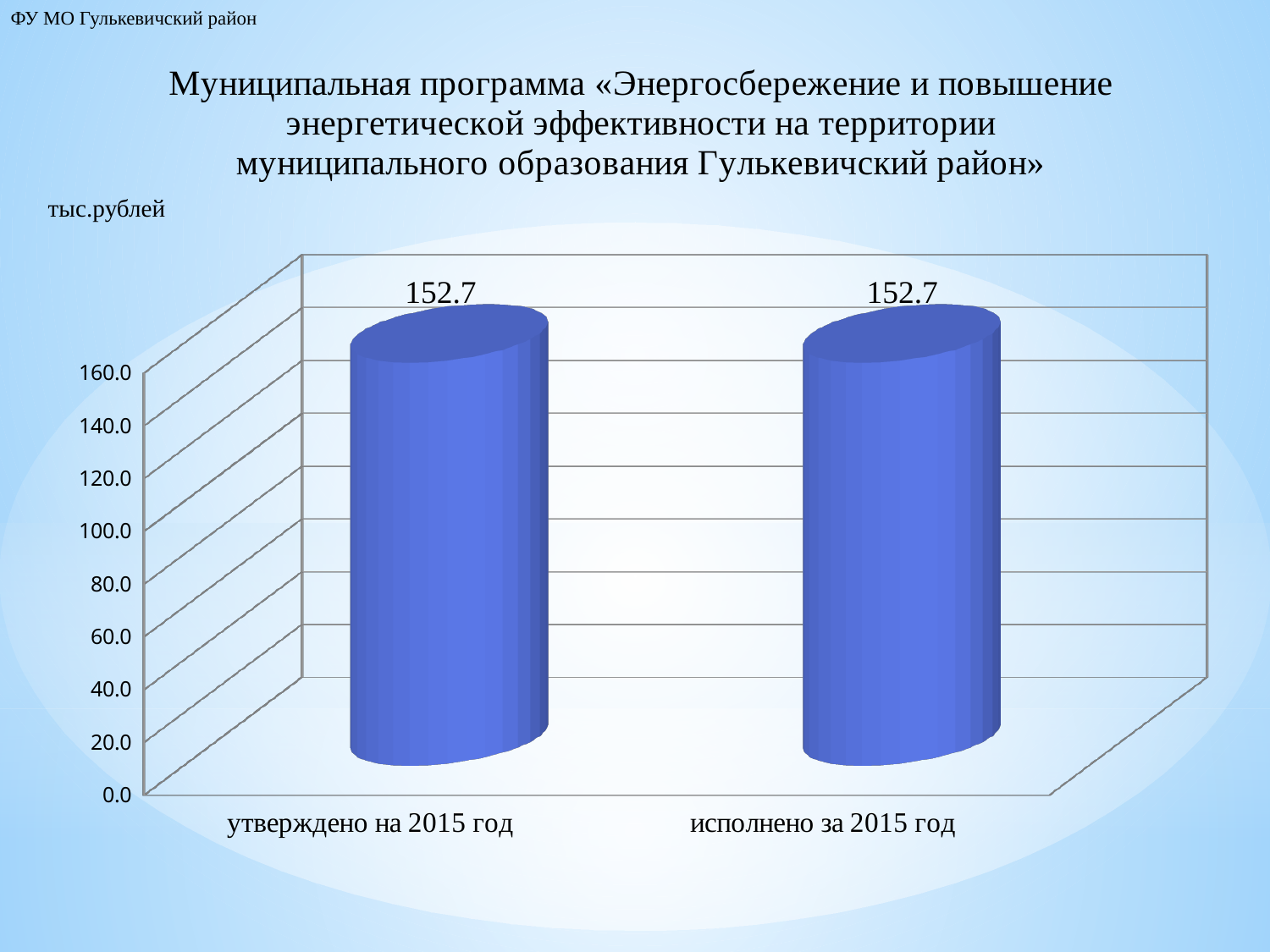
What is the difference between the value for «утверждено на 2015 год» and the value for «исполнено за 2015 год»? 0.0 Is the value for «утверждено на 2015 год» greater or less than 160.0? less What kind of chart is shown on the slide? bar chart Is the value for «утверждено на 2015 год» larger than, smaller than, or equal to the value for «исполнено за 2015 год»? equal What is the highest tick value shown on the vertical axis? 160.0 Is the value for «исполнено за 2015 год» greater or less than 140.0? greater What is the value for «утверждено на 2015 год»? 152.7 What is the value for «исполнено за 2015 год»? 152.7 In what units are the values on the chart expressed, according to the label above the chart? тыс.рублей How many categories are shown on the x axis of the chart? 2